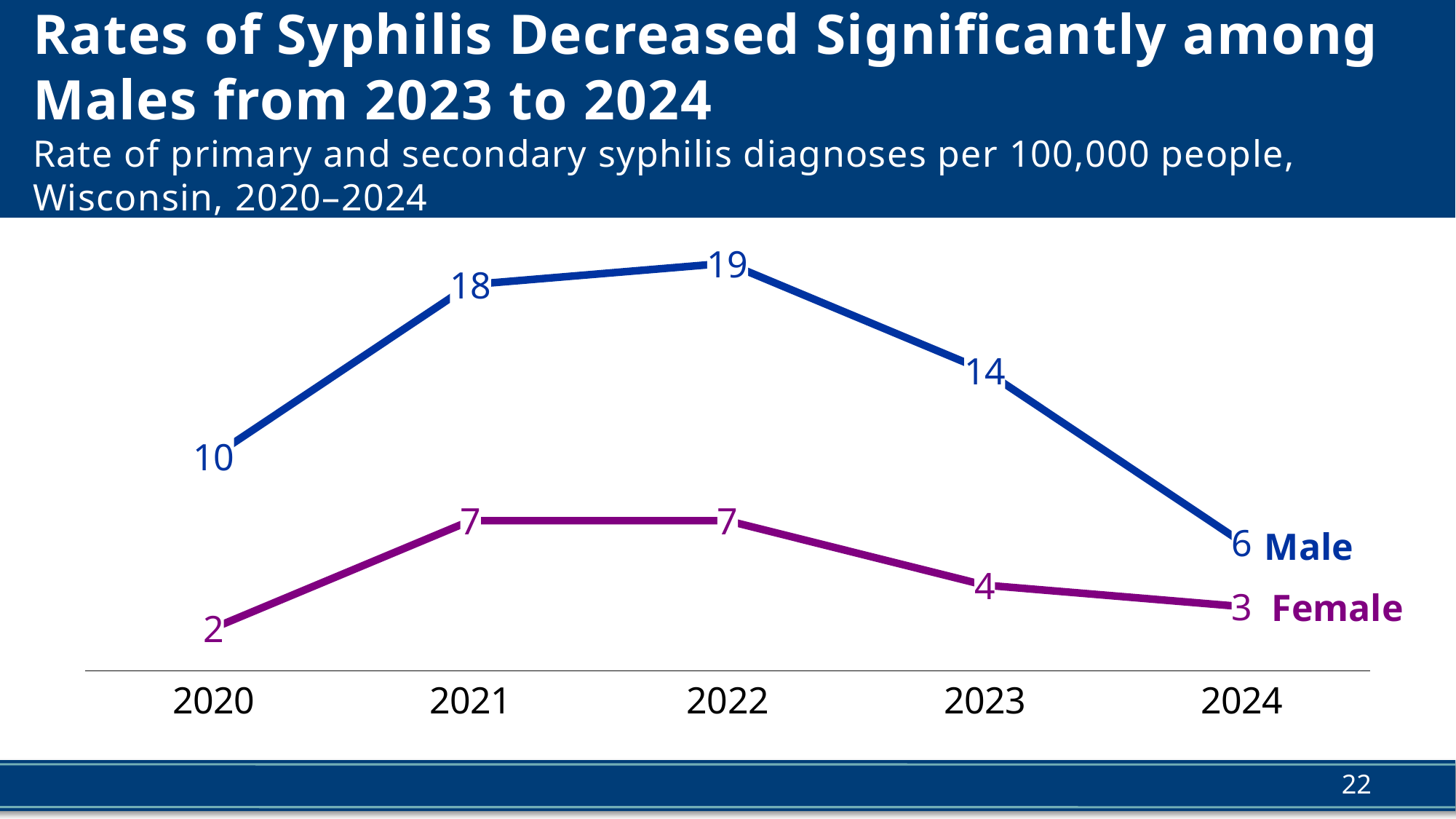
In which year was the female syphilis rate lowest? 2020 What was the syphilis rate for males in 2022? 19 What is the difference between the male and female rates in 2021? 11 Which was higher in 2023, the male rate or the female rate? Male How many years are shown on the x axis? 5 What kind of chart is shown on the slide? Line chart In which year was the male syphilis rate highest? 2022 What was the syphilis rate for females in 2020? 2 Did the male syphilis rate rise or fall from 2022 to 2024? Fall What was the syphilis rate for males in 2024? 6 How many series are plotted on the chart? 2 By how much did the male syphilis rate fall from 2023 to 2024? 8